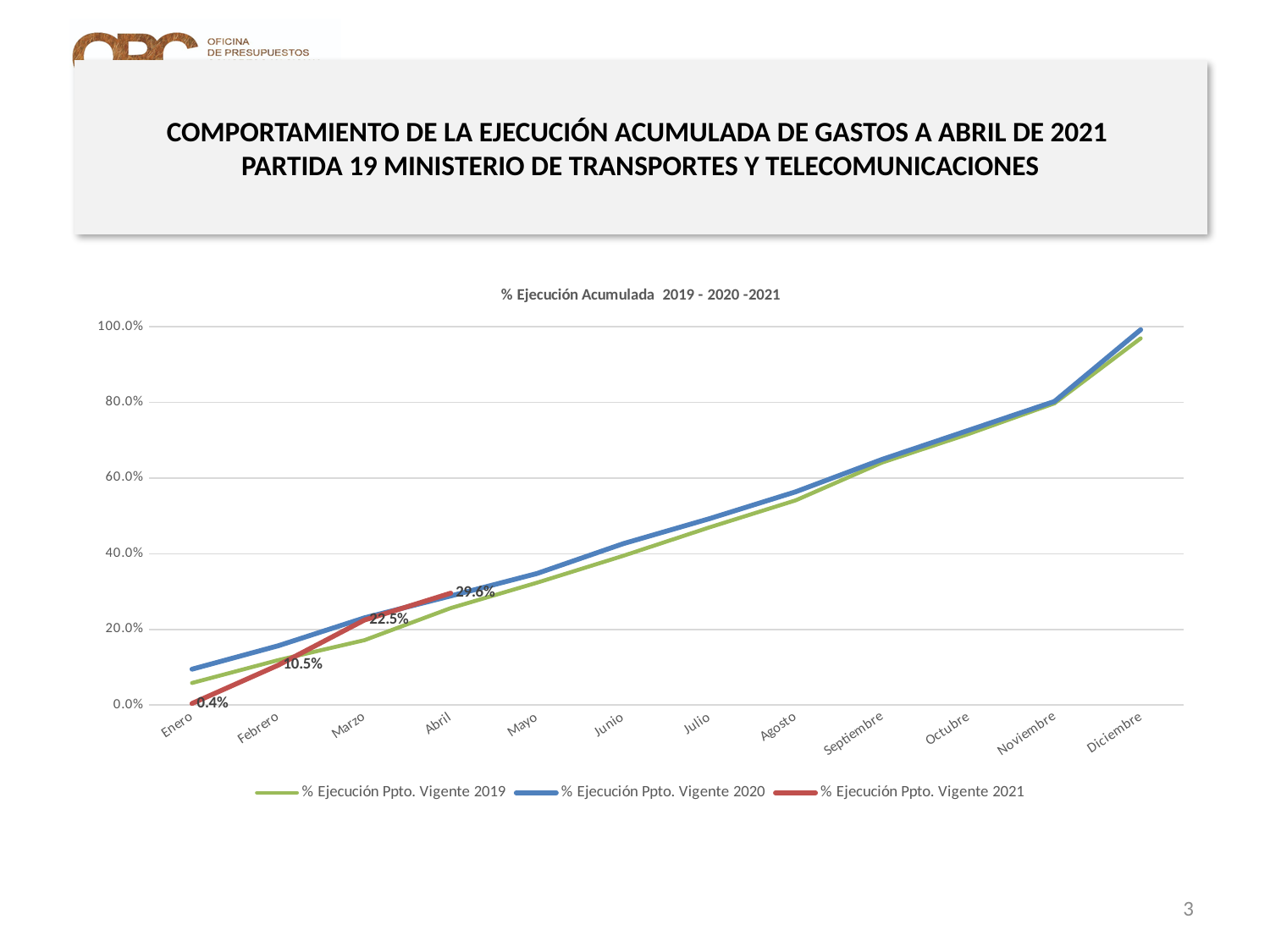
Do the values of % Ejecución Ppto. Vigente 2020 rise or fall from Enero to Diciembre? Rise What is the value of % Ejecución Ppto. Vigente 2021 for Febrero? 10.5% Is the value for % Ejecución Ppto. Vigente 2020 in Diciembre greater or less than 80.0%? greater What is the difference between the 2021 values for Marzo and Febrero? 12.0% What is the value of % Ejecución Ppto. Vigente 2021 for Enero? 0.4% How many series does the legend list? 3 What kind of chart is shown on the slide? Line chart What is the difference between the 2021 values for Abril and Marzo? 7.1% What is the value of % Ejecución Ppto. Vigente 2021 for Marzo? 22.5% In Enero, which series has the larger value: % Ejecución Ppto. Vigente 2020 or % Ejecución Ppto. Vigente 2021? % Ejecución Ppto. Vigente 2020 How many months are shown on the x axis? 12 What is the value of % Ejecución Ppto. Vigente 2021 for Abril? 29.6%